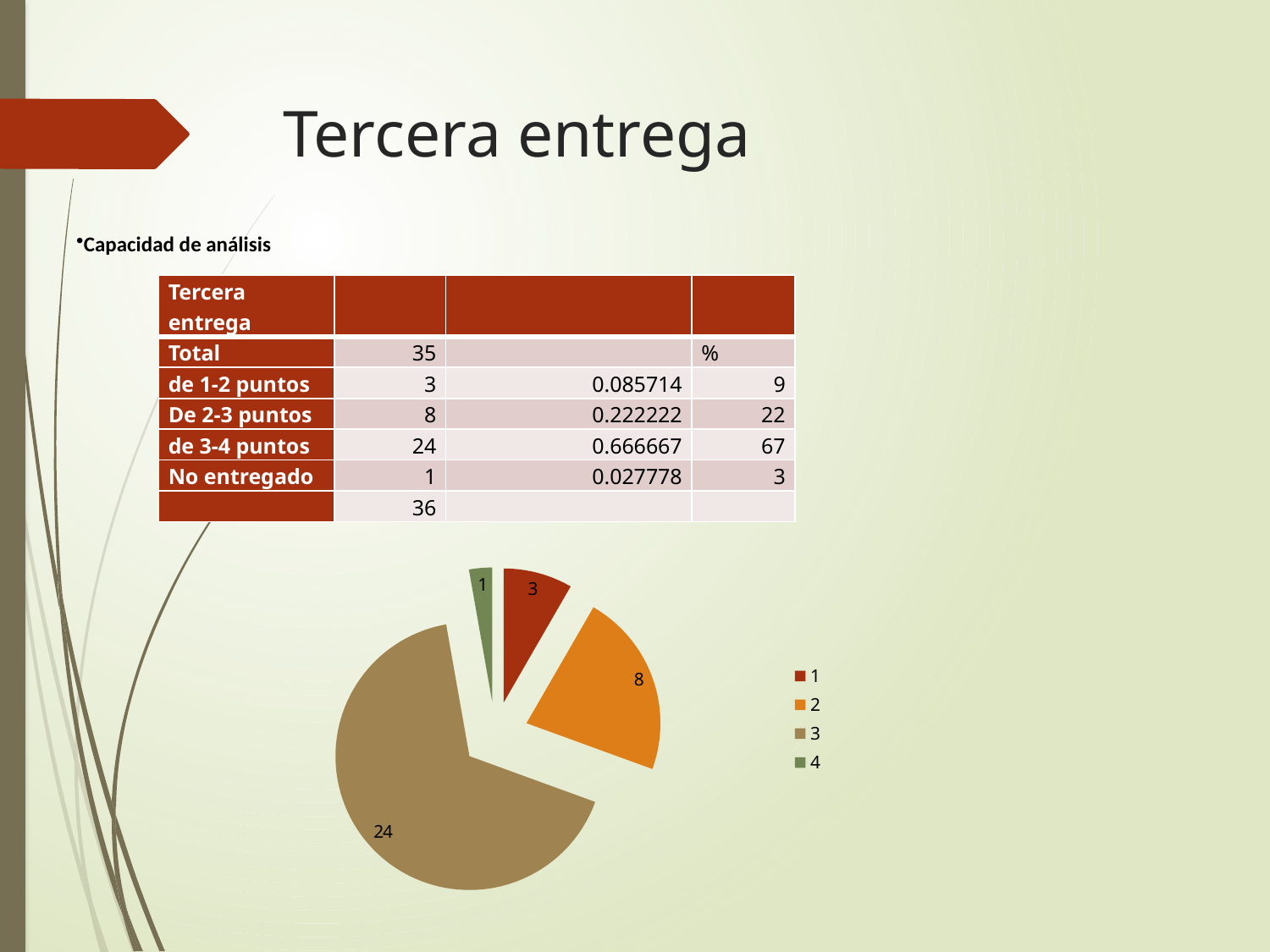
How many entries does the legend list? 4 Which legend category has the smallest slice of the pie? 4 Which legend category has the largest slice of the pie? 3 What is the value of the slice labelled 2 in the legend? 8 What colour is the largest slice of the pie? brown What is the value of the slice labelled 3 in the legend? 24 What is the value of the slice labelled 1 in the legend? 3 What is the value of the slice labelled 4 in the legend? 1 How many slices does the pie chart have? 4 What is the difference between the values of slice 3 and slice 2? 16 What type of chart is shown on the slide? pie chart Which is larger, the value of slice 2 or the value of slice 1? 2